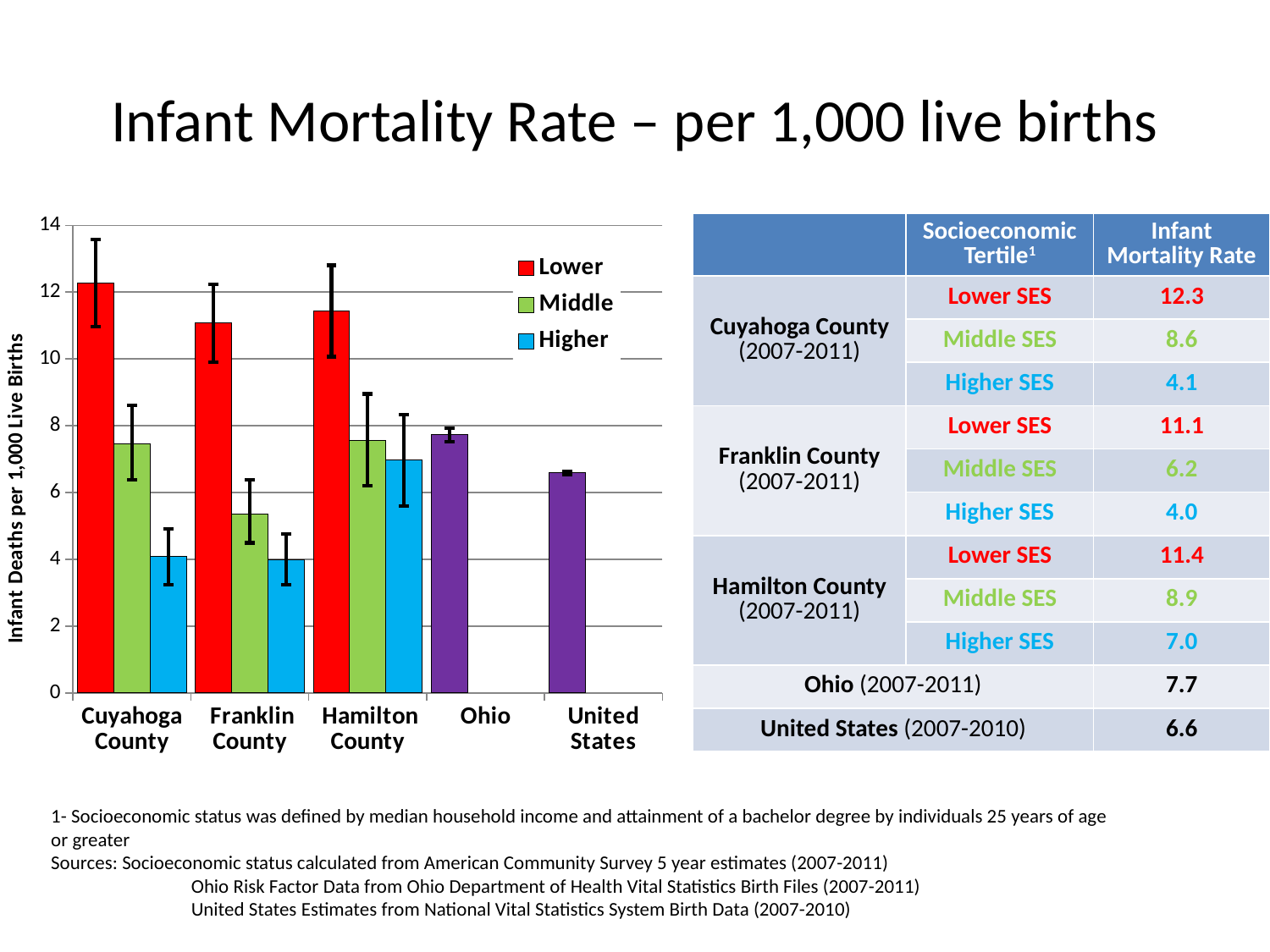
What is the difference between the Lower SES and Higher SES infant mortality rates in Cuyahoga County? 8.2 What is the infant mortality rate for the Higher SES tertile in Hamilton County? 7.0 What kind of chart is shown on the slide? bar chart How many categories are shown along the x axis of the chart? 5 How many series does the chart legend list? 3 What is the difference between the Middle SES infant mortality rates of Hamilton County and Franklin County? 2.7 Which county has the highest Higher SES infant mortality rate? Hamilton County Is the Lower SES value for Franklin County greater or less than 10? greater What is the label on the y axis of the chart? Infant Deaths per 1,000 Live Births What is the infant mortality rate for the Lower SES tertile in Cuyahoga County? 12.3 Which has the higher infant mortality rate, Ohio or the United States? Ohio Which county has the highest Lower SES infant mortality rate? Cuyahoga County